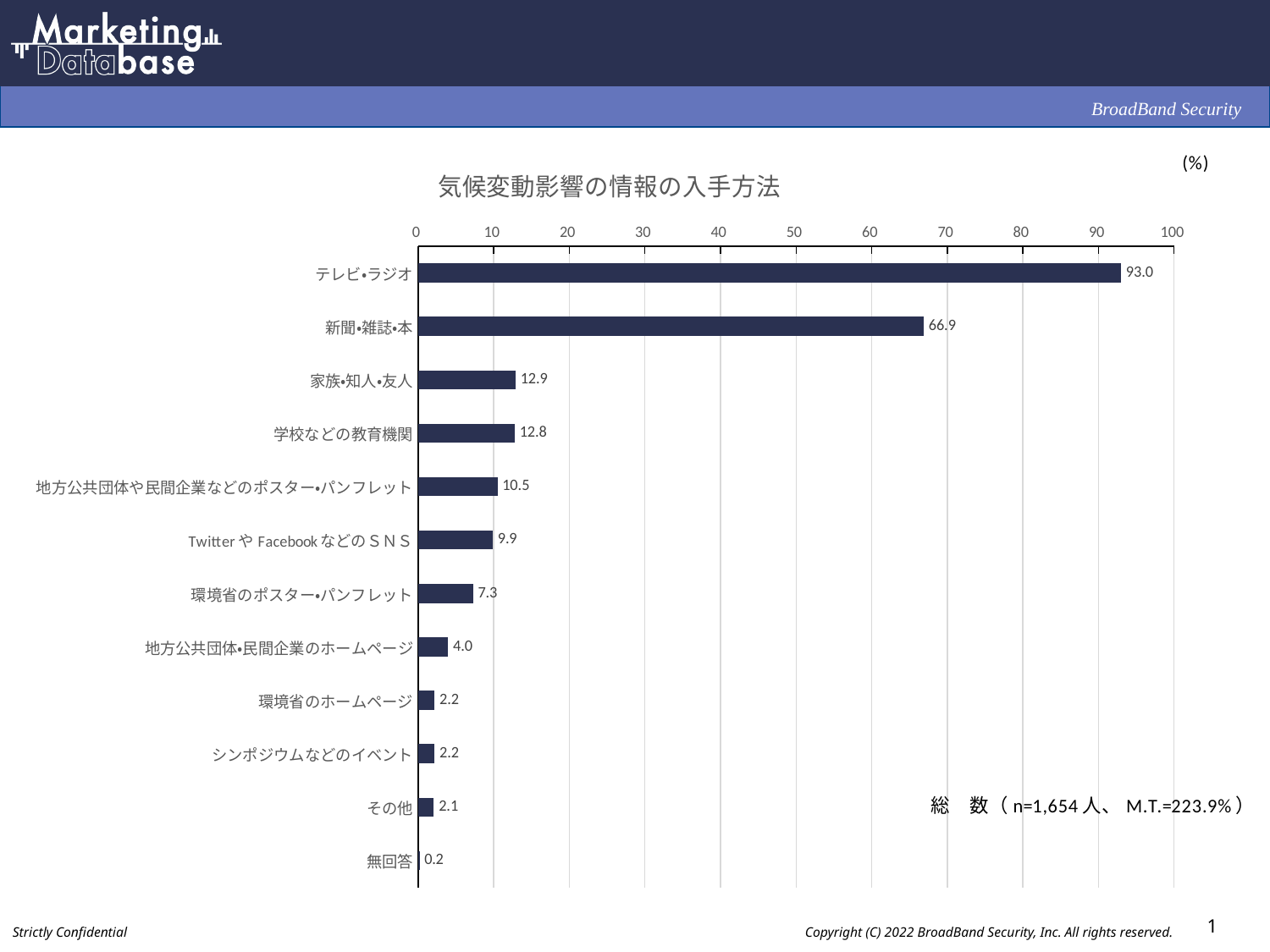
What is the value for 新聞•雑誌•本? 66.9 Which category has the lowest value? 無回答 Which is larger, the value for 家族•知人•友人 or the value for 学校などの教育機関? 家族•知人•友人 Which category has the highest value? テレビ•ラジオ What is the value for テレビ•ラジオ? 93.0 What is the value for Twitter や Facebook などのＳＮＳ? 9.9 What is the difference between the values for テレビ•ラジオ and 新聞•雑誌•本? 26.1 Is the value for 新聞•雑誌•本 greater or less than 60? greater What kind of chart is shown on the slide? bar chart What is the title of the chart? 気候変動影響の情報の入手方法 How many categories are shown in the chart? 12 What is the sample size (n) shown on the slide? 1,654